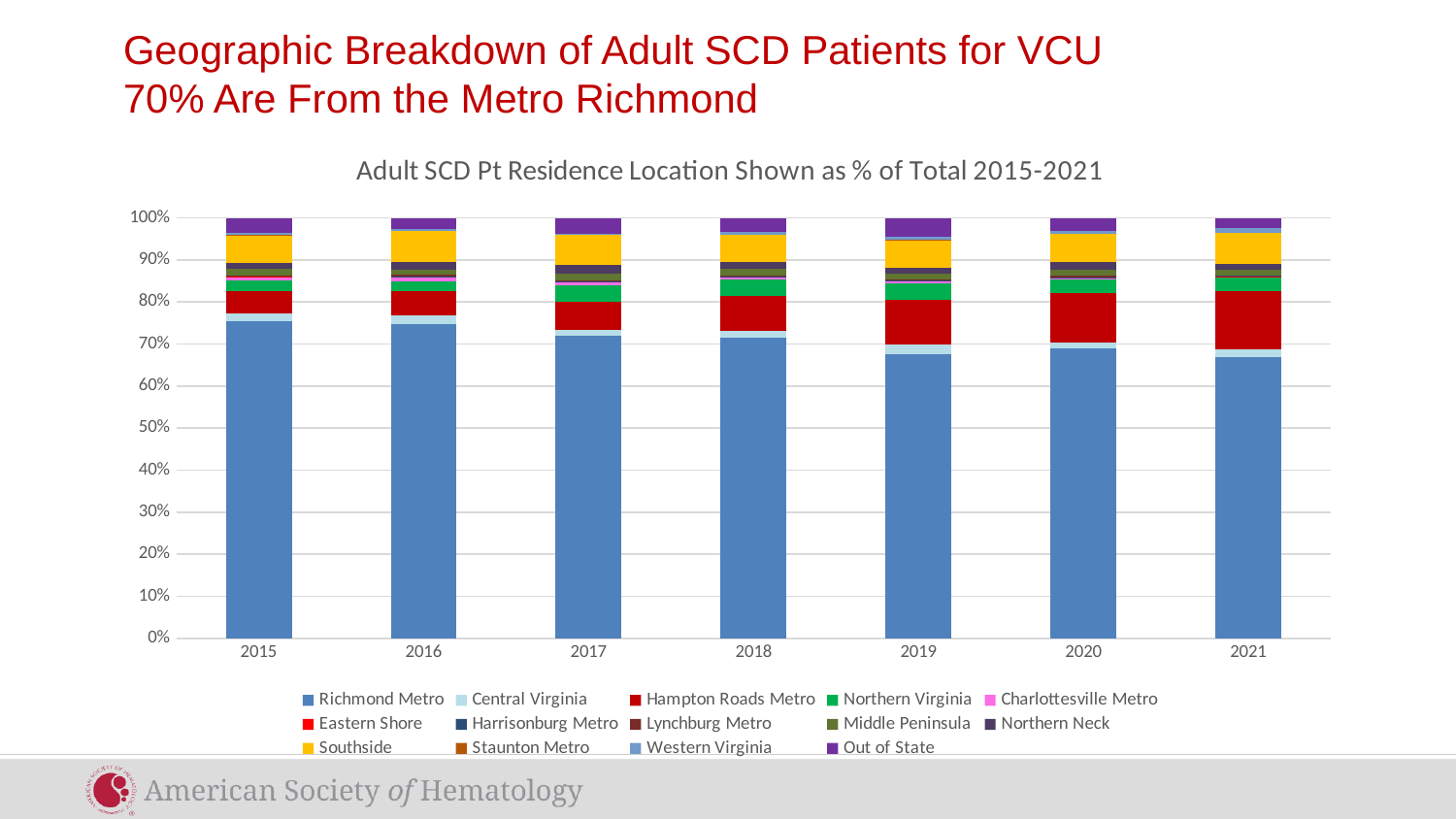
What is the title of the chart? Adult SCD Pt Residence Location Shown as % of Total 2015-2021 How many years are shown along the x axis of the chart? 7 Which series makes up the largest segment of every bar? Richmond Metro Is the Richmond Metro share in 2016 greater or less than 80%? less Is the Richmond Metro share in 2021 greater or less than 70%? less Which year has the larger Richmond Metro share, 2015 or 2021? 2015 Does the Richmond Metro share generally rise or fall from 2015 to 2021? fall How many series does the chart's legend list? 14 Is the Richmond Metro share in 2019 greater or less than 70%? less What kind of chart is shown on the slide? Stacked bar chart In which year is the Richmond Metro share the highest? 2015